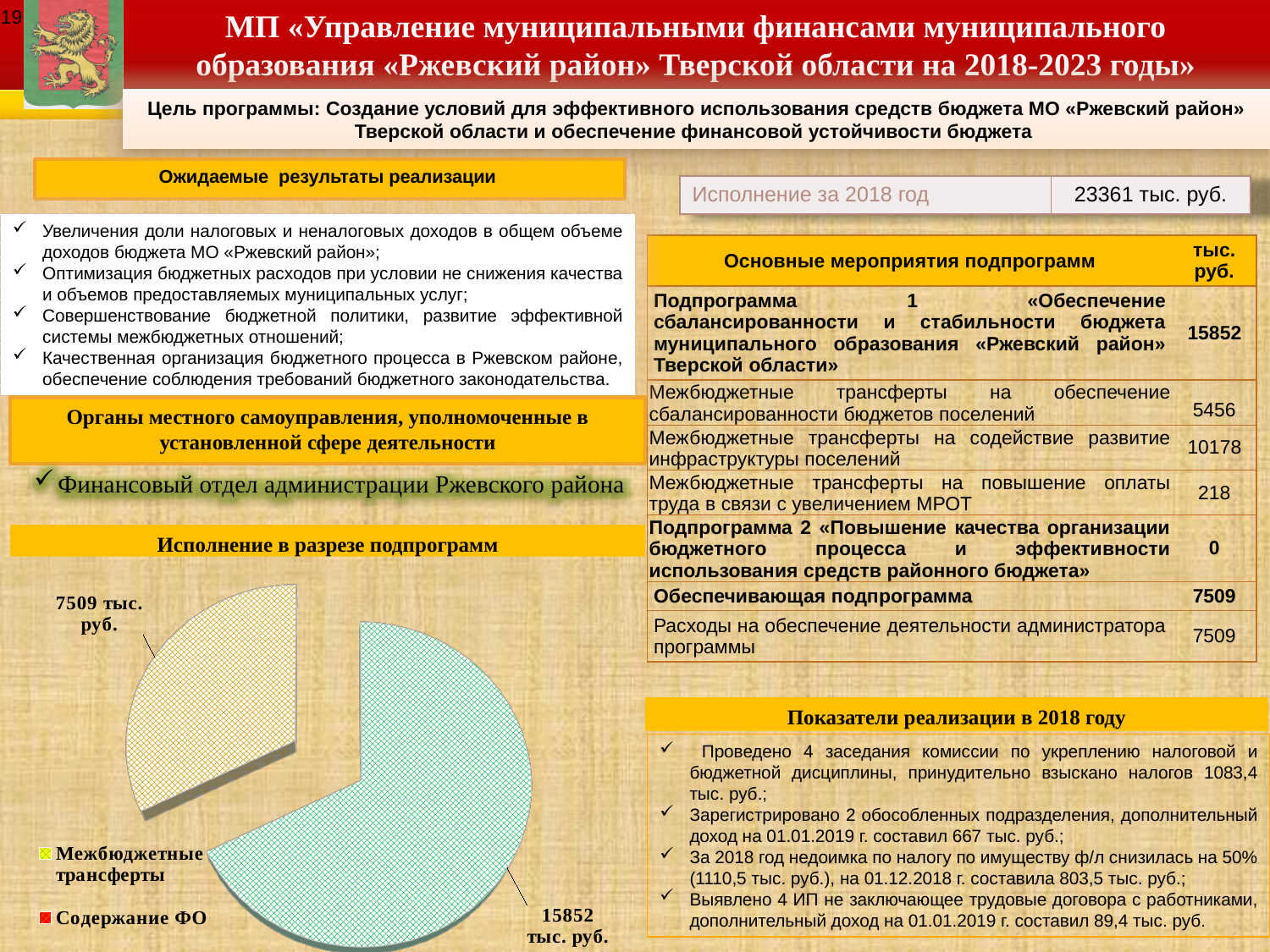
What are the two entries in the legend of the pie chart? Межбюджетные трансферты; Содержание ФО What value is labelled on the larger slice of the pie chart? 15852 тыс. руб. What value is labelled on the smaller slice of the pie chart? 7509 тыс. руб. Is the slice labelled 7509 тыс. руб. larger or smaller than the slice labelled 15852 тыс. руб.? smaller Which of the two labelled values in the pie chart is the largest? 15852 тыс. руб. What is the difference between the two slice values in the pie chart (15852 and 7509 тыс. руб.)? 8343 тыс. руб. What kind of chart is shown under the heading «Исполнение в разрезе подпрограмм»? pie chart What is the title above the pie chart? Исполнение в разрезе подпрограмм What is the total of the two slice values shown in the pie chart? 23361 тыс. руб. How many entries does the legend of the pie chart list? 2 Which of the two labelled values in the pie chart is the smallest? 7509 тыс. руб. How many slices does the pie chart «Исполнение в разрезе подпрограмм» have? 2